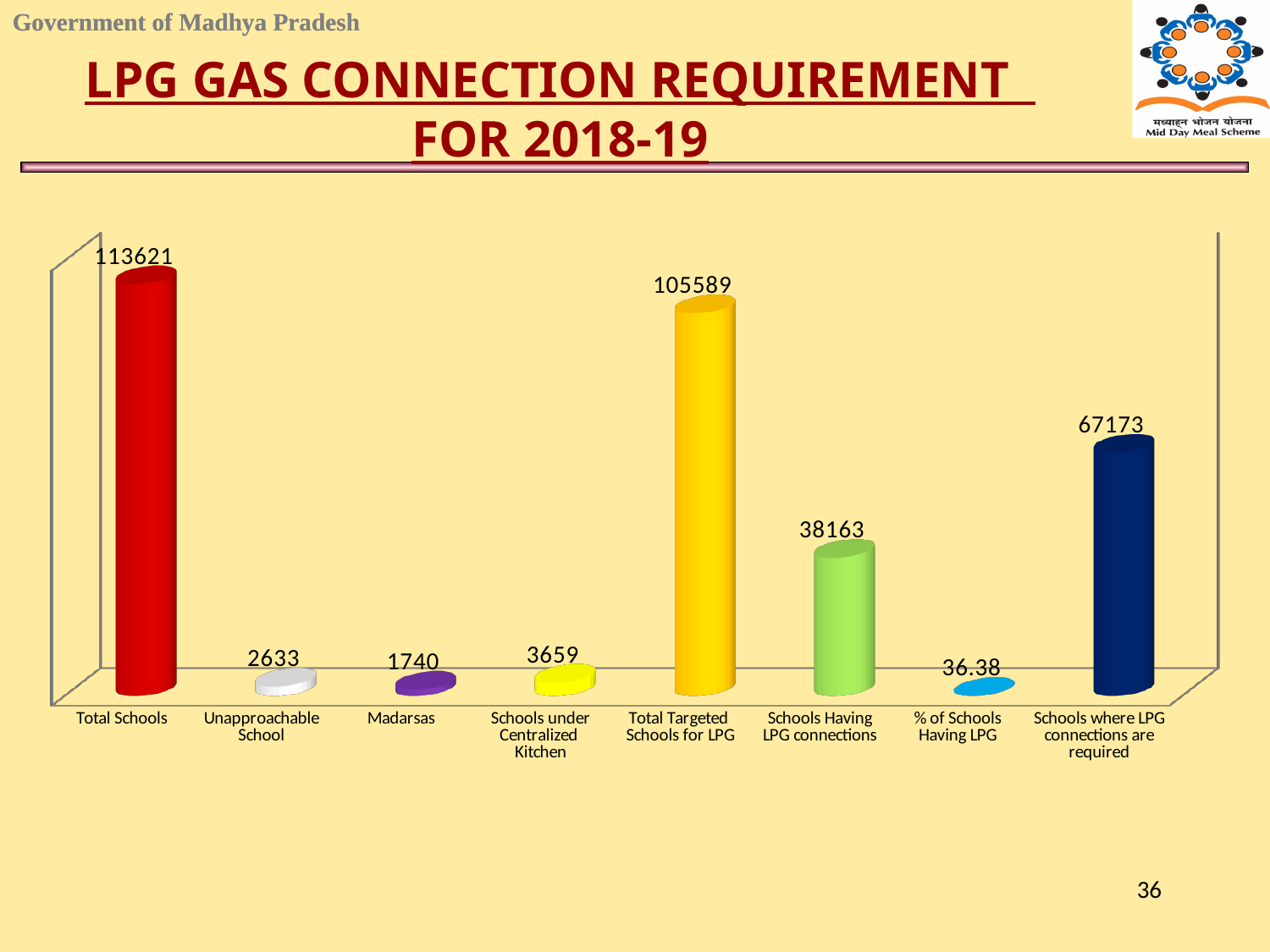
Which category has the lowest value? % of Schools Having LPG What colour is the bar for Total Targeted Schools for LPG? yellow What is the value for Schools Having LPG connections? 38163 How many categories are shown on the chart? 8 What is the difference between Total Targeted Schools for LPG and Schools Having LPG connections? 67426 What is the value for % of Schools Having LPG? 36.38 Which category has the highest value? Total Schools What is the value for Total Schools? 113621 What is the difference between Total Schools and Total Targeted Schools for LPG? 8032 What kind of chart is shown on the slide? bar chart Which is larger, Schools under Centralized Kitchen or Unapproachable School? Schools under Centralized Kitchen What is the value for Schools where LPG connections are required? 67173